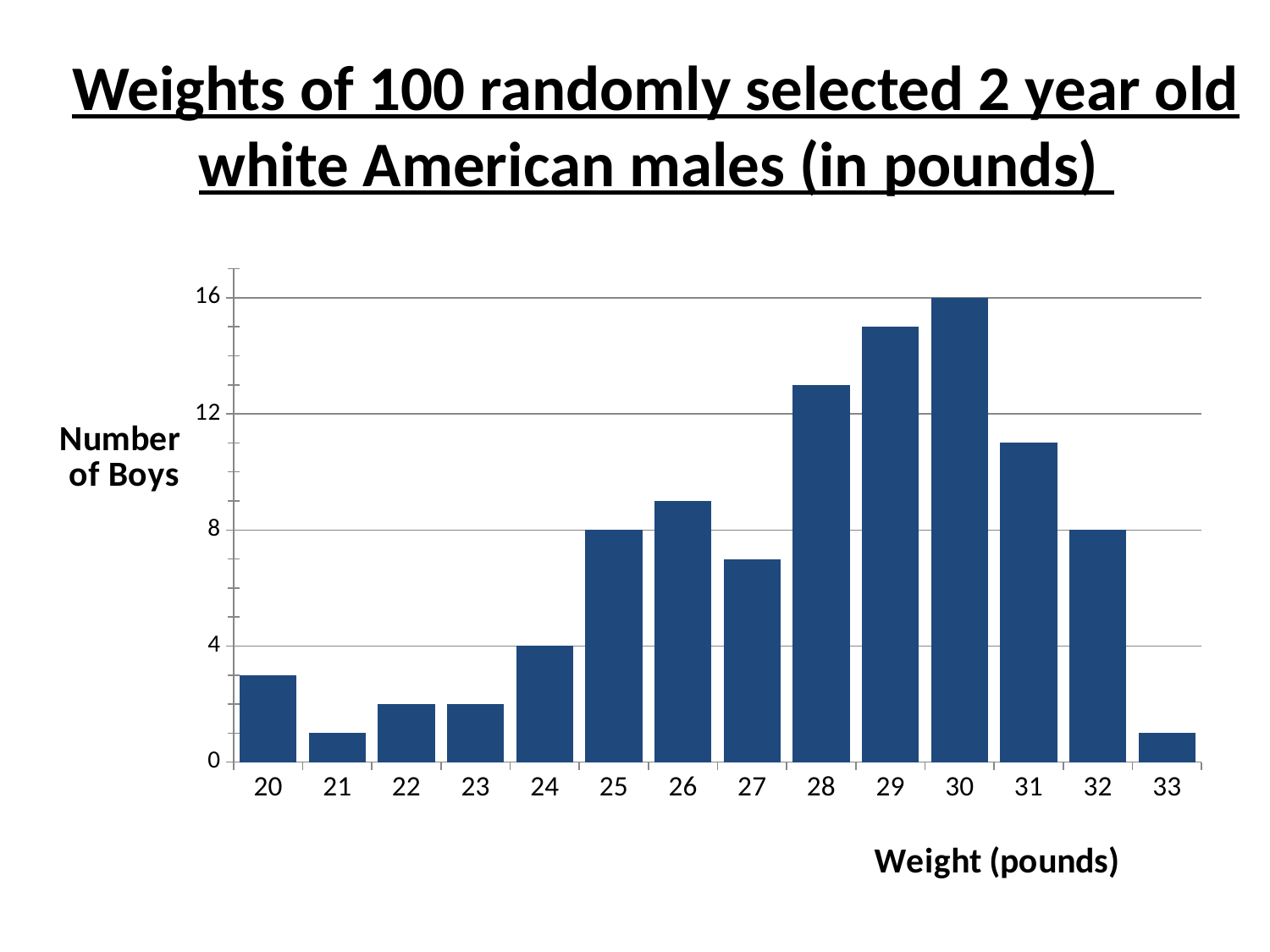
Is the number of boys for 21 pounds greater or less than 4? less What is the number of boys for a weight of 25 pounds? 8 What is the number of boys for a weight of 24 pounds? 4 Is the number of boys for 27 pounds greater or less than 8? less Which has more boys, 29 pounds or 31 pounds? 29 pounds Which weight has the highest number of boys? 30 What is the difference between the number of boys at 30 pounds and at 25 pounds? 8 How many weight categories are shown on the x axis? 14 What is the label of the x axis? Weight (pounds) What kind of chart is shown on the slide? bar chart Is the number of boys for 28 pounds greater or less than 12? greater What is the number of boys for a weight of 30 pounds? 16